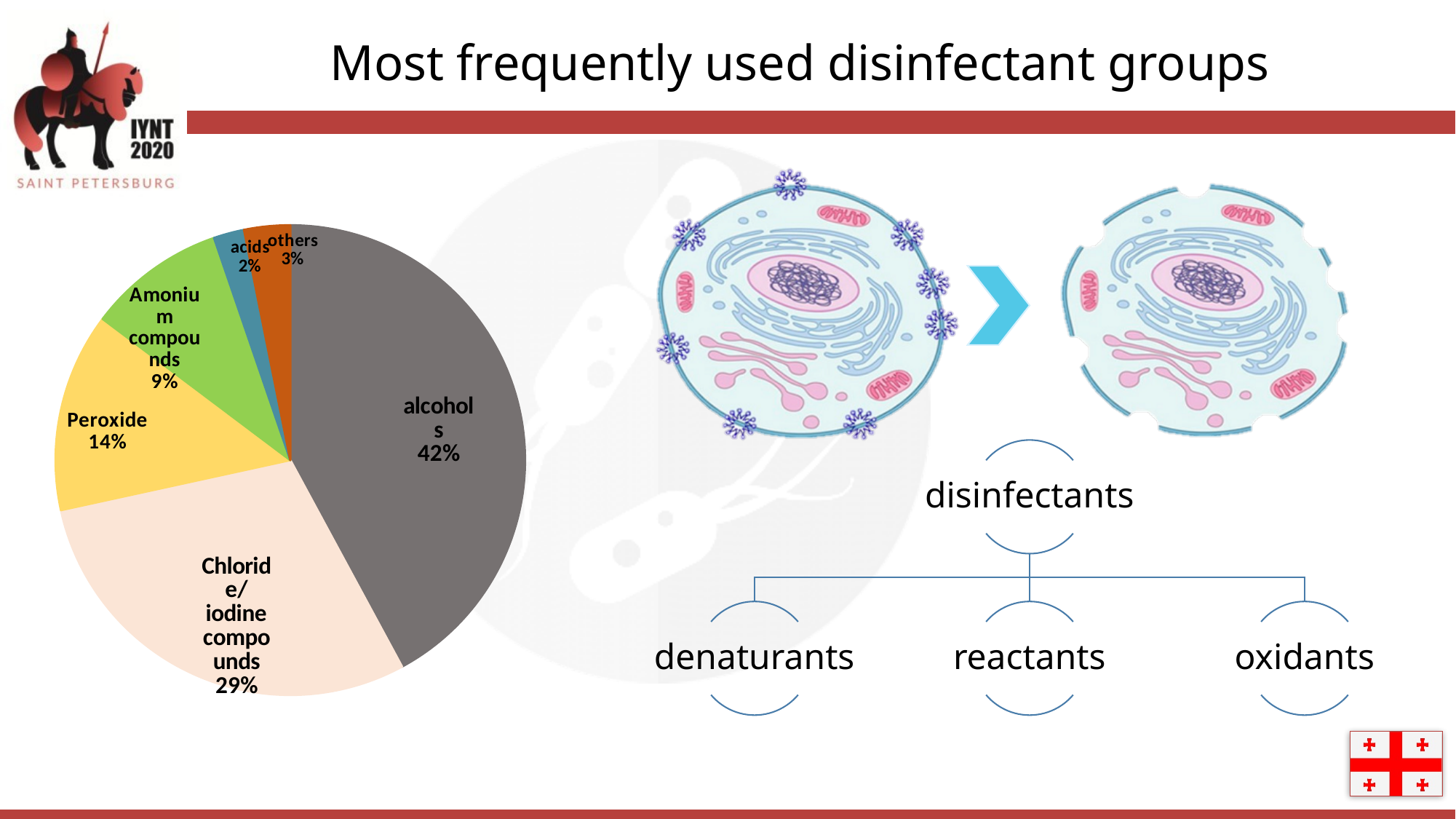
How many slices does the pie chart have? 6 What share does Chloride/iodine compounds have in the pie chart? 29% Which is larger in the pie chart, Peroxide or Amonium compounds? Peroxide Which category has the smallest slice of the pie chart? acids What colour is the alcohols slice in the pie chart? grey What is the difference between the alcohols share and the Chloride/iodine compounds share? 13% Which category has the largest slice of the pie chart? alcohols What percentage of the pie chart is alcohols? 42% What is the value for Peroxide in the pie chart? 14% What is the value for acids in the pie chart? 2% What percentage is shown for Amonium compounds? 9% What type of chart is shown on the slide? pie chart